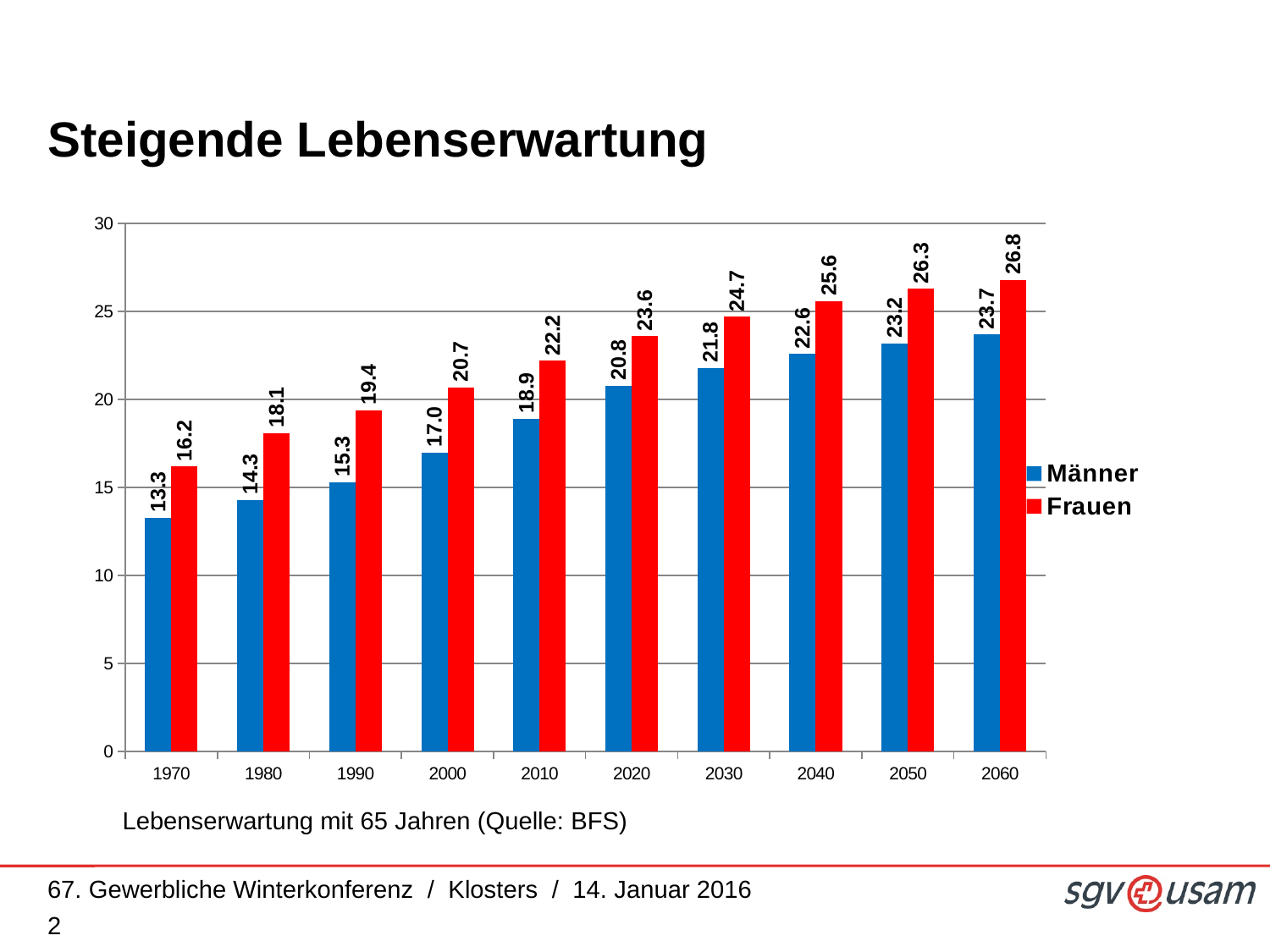
In which year is the value for Frauen highest? 2060 What kind of chart is shown on the slide? Bar chart What is the difference between the Frauen and Männer values in 2020? 2.8 What is the value for Frauen in 2000? 20.7 How many years are shown on the x axis? 10 What is the value for Männer in 1970? 13.3 How many series does the legend list? 2 Which is larger in 1990, the value for Männer or for Frauen? Frauen Do the values for Männer rise or fall from 1970 to 2060? Rise What is the value for Frauen in 2060? 26.8 In which year is the value for Männer lowest? 1970 What is the value for Männer in 2030? 21.8